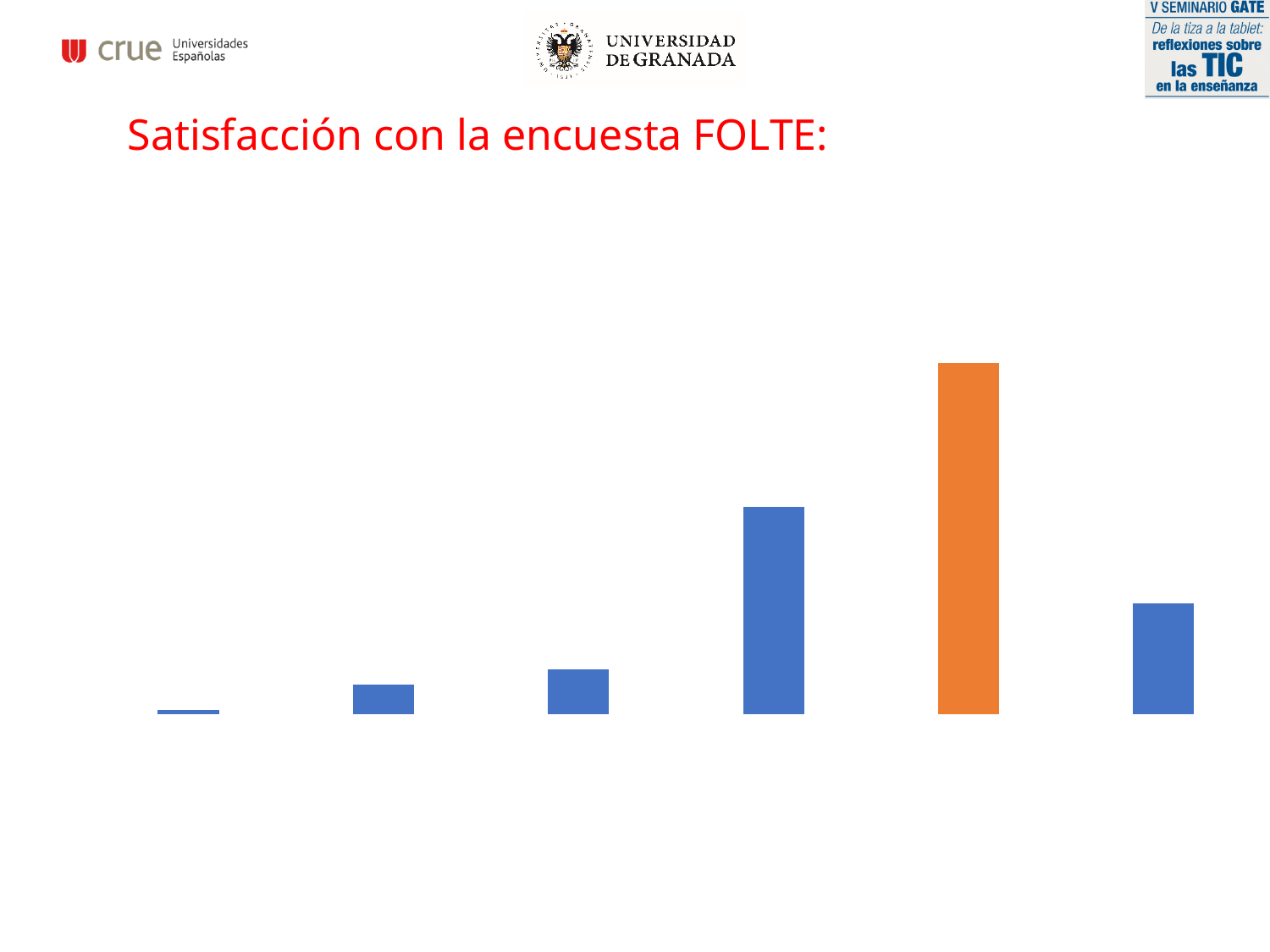
Do the bar heights rise or fall from the first bar to the fifth bar? rise What is the title shown above the chart on the slide? Satisfacción con la encuesta FOLTE: How many bars does the chart contain? 6 What kind of chart is shown on the slide? bar chart Which is taller, the second bar from the left or the third bar from the left? the third bar Counting from the left, which bar is the shortest? the first bar Which is taller, the fourth bar from the left or the sixth bar from the left? the fourth bar Counting from the left, which bar is the tallest? the fifth bar What colour is the tallest bar in the chart? orange